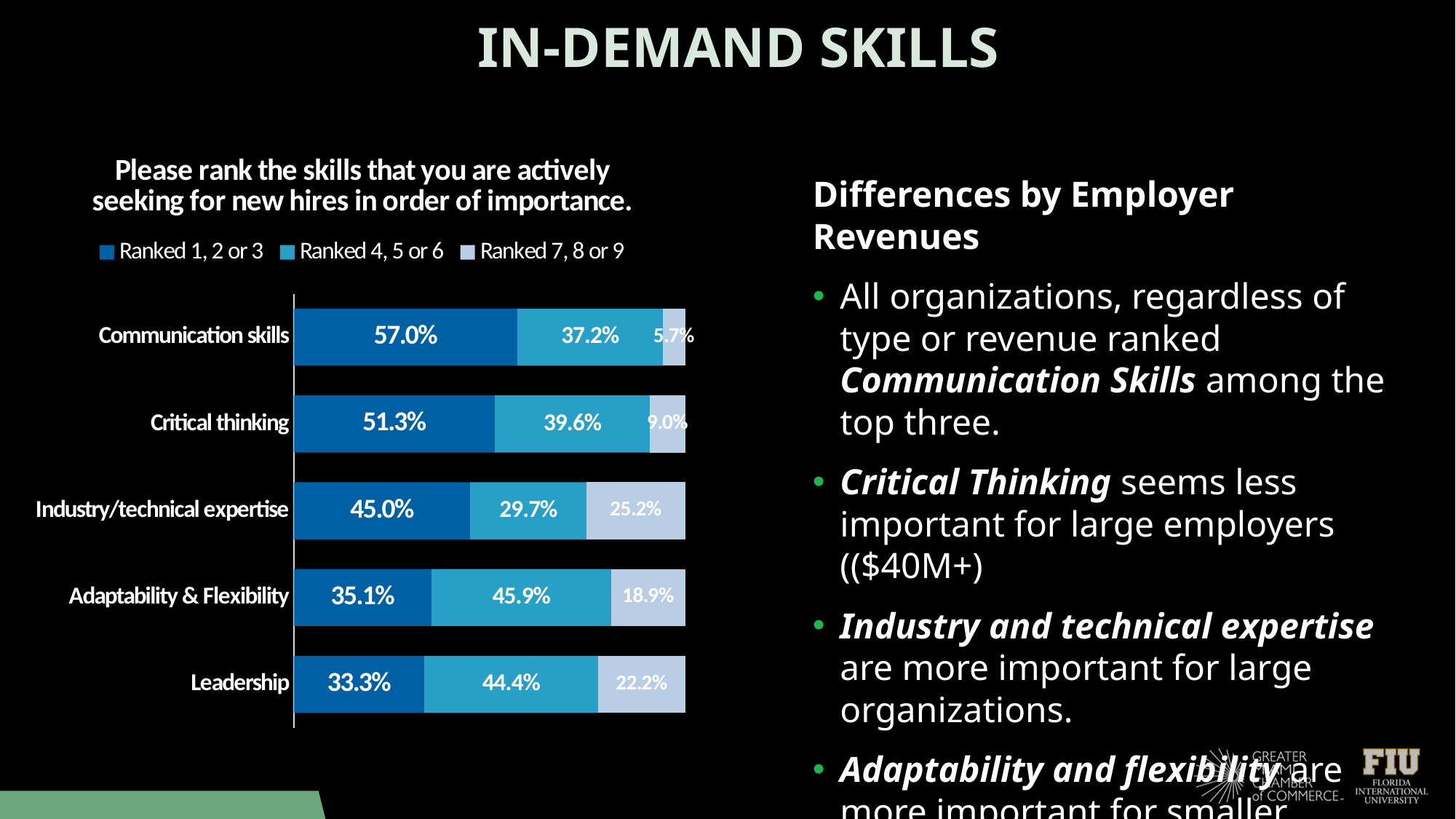
Which has a larger 'Ranked 4, 5 or 6' value: Adaptability & Flexibility or Critical thinking? Adaptability & Flexibility How many series does the legend list? 3 What is the difference in percentage points between the 'Ranked 1, 2 or 3' values for Communication skills and Leadership? 23.7 percentage points What type of chart is shown on the slide? Stacked bar chart Which skill has the smallest share of respondents ranking it 7, 8 or 9? Communication skills What percentage of respondents ranked Adaptability & Flexibility 1, 2 or 3? 35.1% Which skill has the lowest share of respondents ranking it 1, 2 or 3? Leadership How many skills are shown in the chart? 5 What percentage of respondents ranked Communication skills 1, 2 or 3? 57.0% Which skill has the highest share of respondents ranking it 1, 2 or 3? Communication skills What percentage of respondents ranked Leadership 4, 5 or 6? 44.4% What percentage of respondents ranked Industry/technical expertise 7, 8 or 9? 25.2%